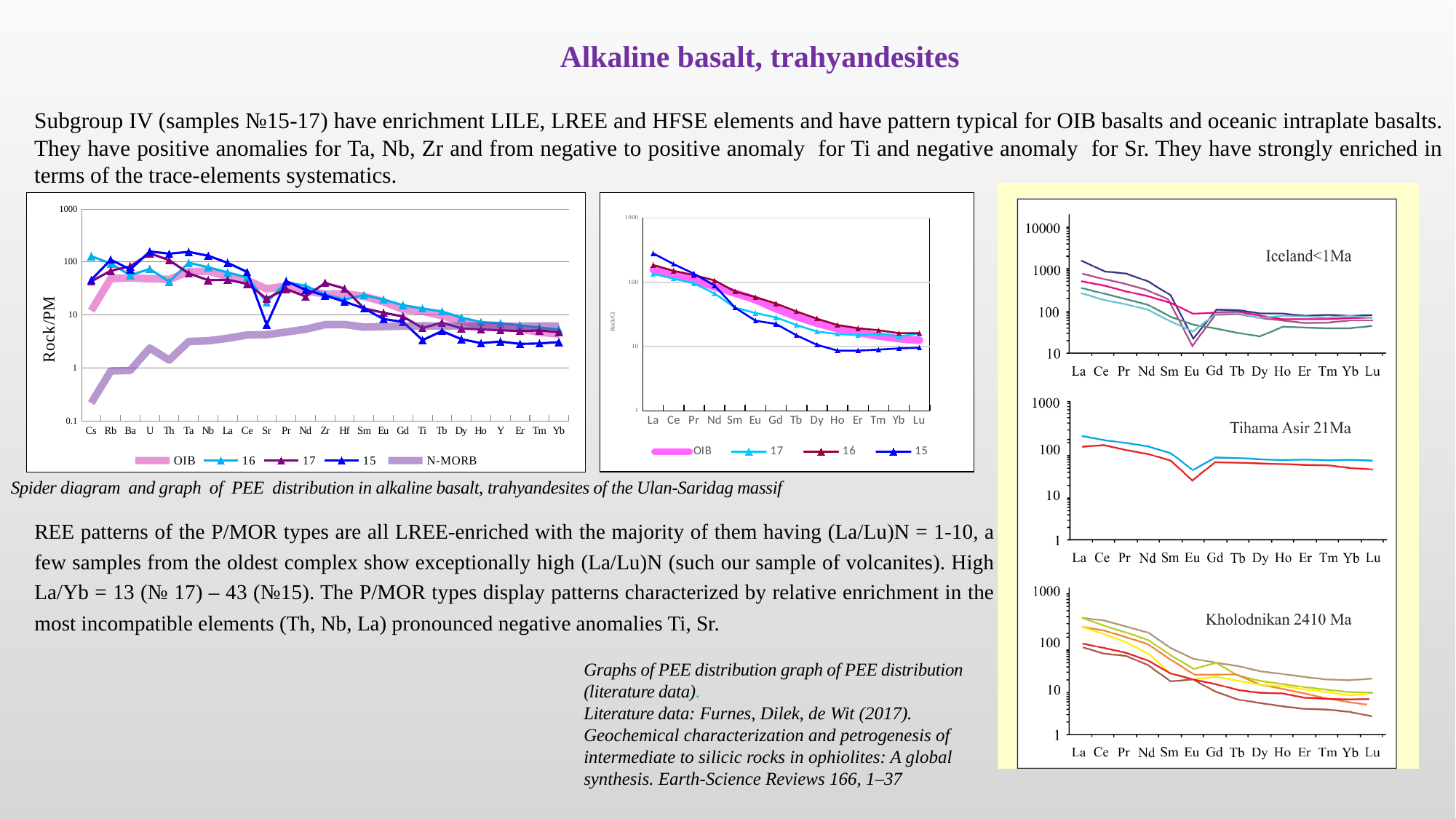
What is the y-axis label of the left spider diagram? Rock/PM How many elements are plotted along the x axis of the left spider diagram? 25 In the middle REE chart, is the value of series 15 at Ho greater or less than 10? less How many elements are plotted along the x axis of the middle REE chart? 14 In the middle REE chart, do the values of series 15 rise or fall from La to Lu? fall How many series does the legend of the left spider diagram list? 5 In the left spider diagram, is the N-MORB value for Cs greater or less than 1? less In the Tihama Asir 21Ma chart, do the values rise or fall from La to Sm? fall How many series does the legend of the middle REE chart list? 4 What kind of chart is the left chart with the Rock/PM axis? line chart In the left spider diagram, is the value of series 15 at Sr greater or less than 10? less